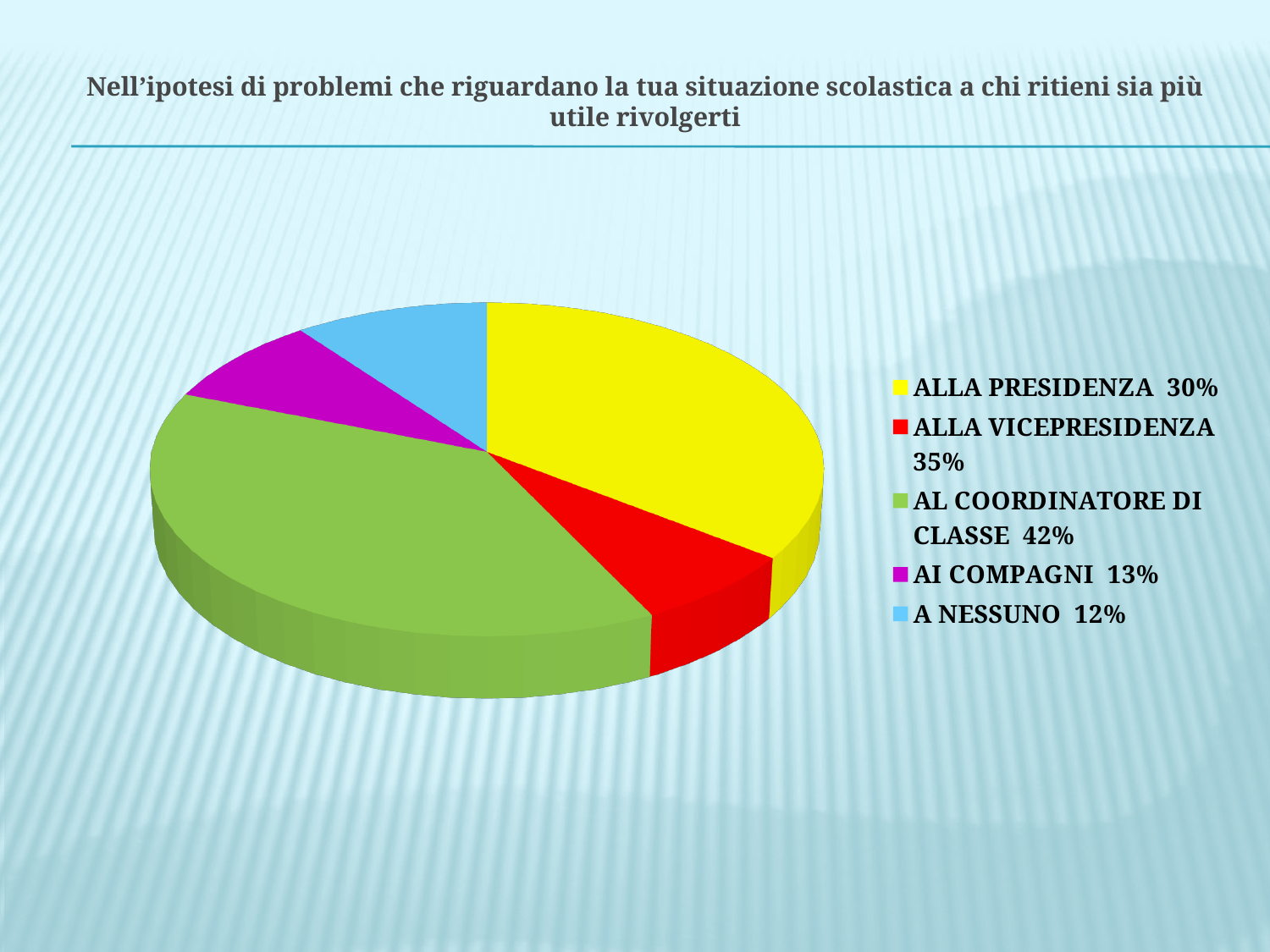
Which is larger, the share for AL COORDINATORE DI CLASSE or the share for ALLA PRESIDENZA? AL COORDINATORE DI CLASSE How many categories does the pie chart have? 5 What percentage is shown for ALLA VICEPRESIDENZA? 35% What kind of chart is shown on the slide? pie chart What colour is the slice for AL COORDINATORE DI CLASSE? green What percentage is shown for ALLA PRESIDENZA? 30% Which category has the largest share of the pie? AL COORDINATORE DI CLASSE What is the difference in percentage points between AL COORDINATORE DI CLASSE (42%) and ALLA PRESIDENZA (30%)? 12 What percentage is shown for A NESSUNO? 12% What colour is the slice for ALLA PRESIDENZA? yellow What percentage is shown for AI COMPAGNI? 13% What percentage is shown for AL COORDINATORE DI CLASSE? 42%